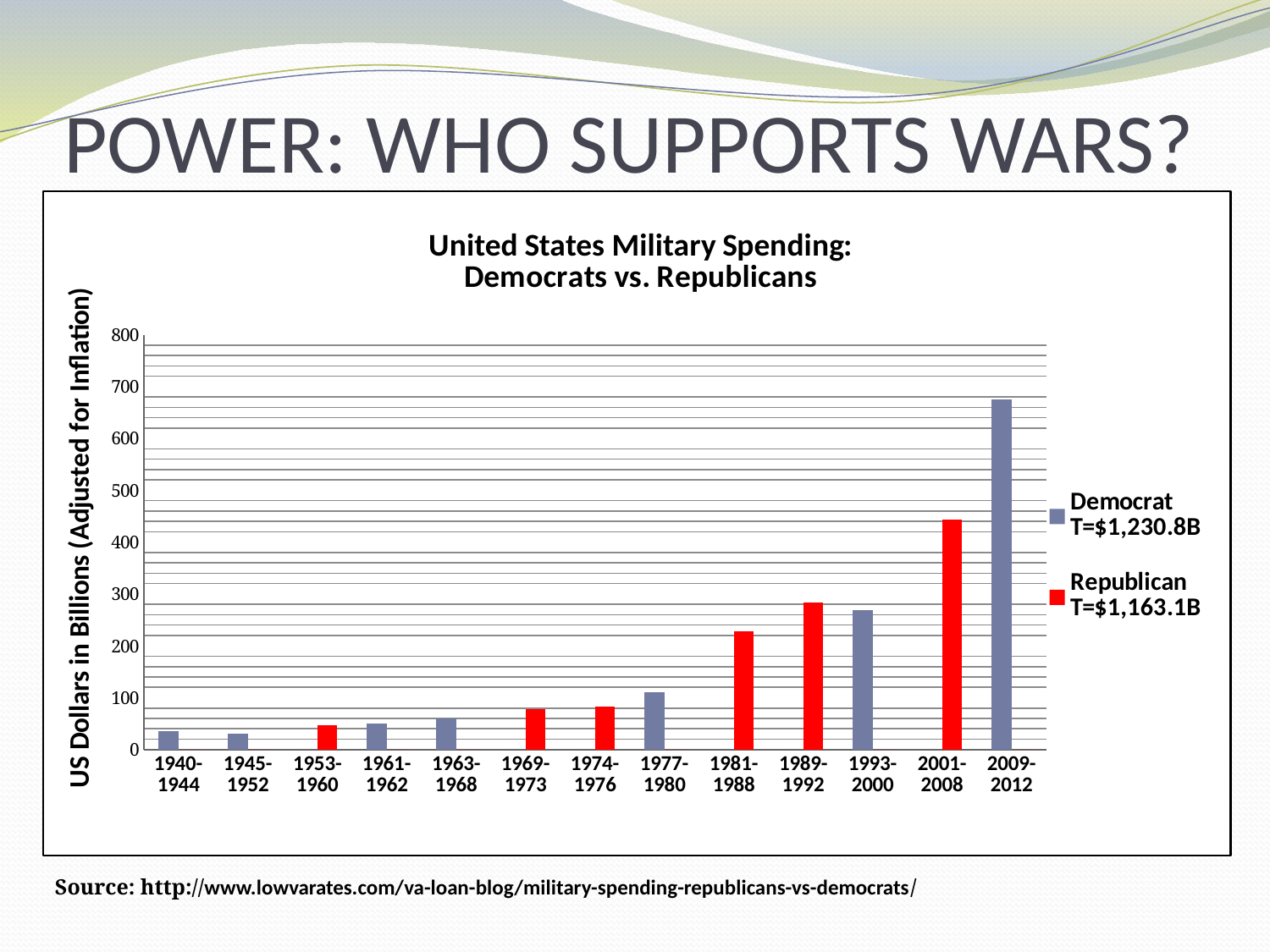
According to the legend, what is the total spending shown for Democrats? T=$1,230.8B Do the values generally rise or fall moving from left to right along the x axis? rise Which is larger, the value for 2001-2008 or the value for 2009-2012? 2009-2012 Which is larger, the value for 1981-1988 or the value for 1989-1992? 1989-1992 What kind of chart is shown on the slide? bar chart Is the value for 2001-2008 greater or less than 400? greater How many series does the chart's legend list? 2 How many time periods are shown along the x axis of the chart? 13 Is the value for 2009-2012 greater or less than 600? greater Is the value for 1981-1988 greater or less than 200? greater Which time period has the highest military spending in the chart? 2009-2012